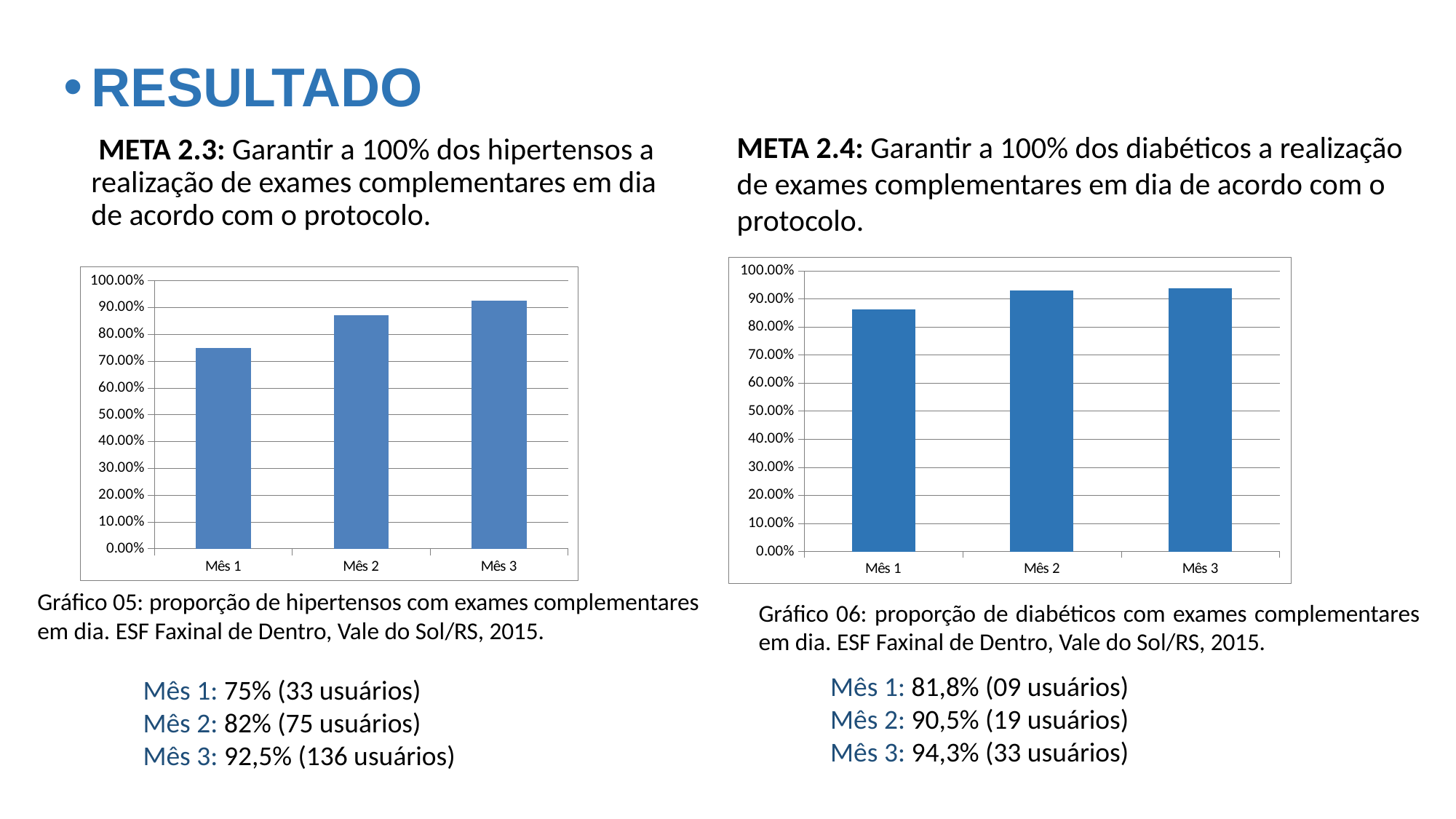
In Gráfico 05 (left chart), which month has the highest value? Mês 3 In Gráfico 06 (right chart), which is larger, the value for Mês 1 or the value for Mês 3? Mês 3 In Gráfico 05 (left chart), do the values rise or fall from Mês 1 to Mês 3? rise In Gráfico 05 (left chart), is the value for Mês 2 greater or less than 80.00%? greater In Gráfico 06 (right chart), which month has the lowest value? Mês 1 In Gráfico 05 (left chart), is the value for Mês 1 greater or less than 80.00%? less What kind of chart is Gráfico 06 (right chart)? bar chart In Gráfico 06 (right chart), is the value for Mês 1 greater or less than 90.00%? less In Gráfico 05 (left chart), which month has the lowest value? Mês 1 How many bars are plotted in Gráfico 05 (left chart)? 3